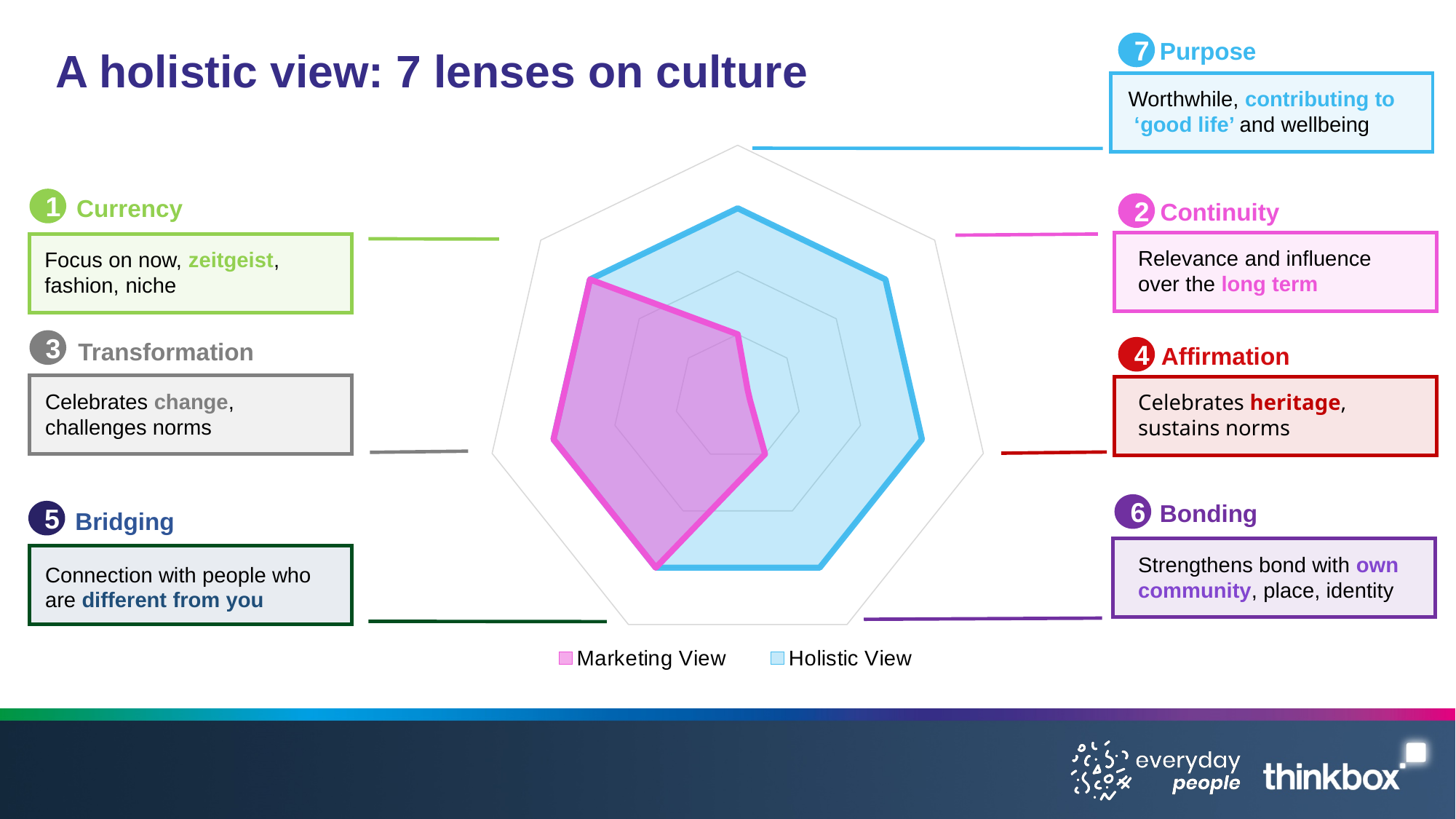
What kind of chart is shown on the slide? radar chart How many axes (lenses) does the radar chart have? 7 On the Bonding axis, which series has the larger value, Marketing View or Holistic View? Holistic View Which series covers the larger area of the radar chart overall? Holistic View On the Affirmation axis, which series has the larger value, Marketing View or Holistic View? Holistic View How many series does the chart's legend list? 2 What are the two series named in the chart legend? Marketing View and Holistic View Which colour represents the Marketing View series in the chart? pink